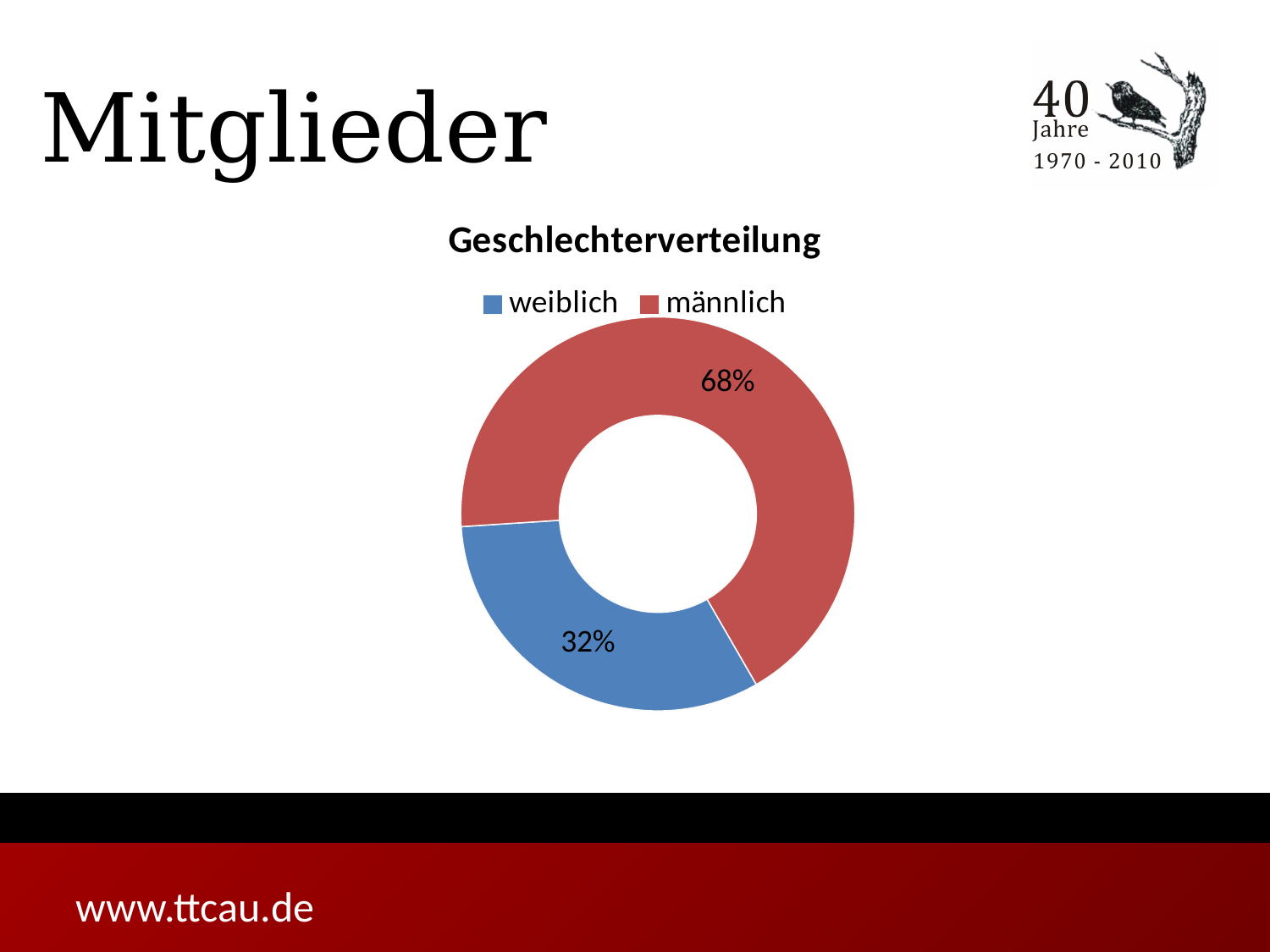
What colour is the 'weiblich' slice? Blue How many categories are shown in the chart? 2 What kind of chart is shown on the slide? Doughnut chart What is the difference in percentage points between the 'männlich' and 'weiblich' slices? 36 Which category has the largest slice? männlich What share of the chart does the 'männlich' slice represent? 68% How many entries does the legend list? 2 What is the title of the chart? Geschlechterverteilung What share of the chart does the 'weiblich' slice represent? 32% Which is larger, the 'weiblich' slice or the 'männlich' slice? männlich Which category has the smallest slice? weiblich